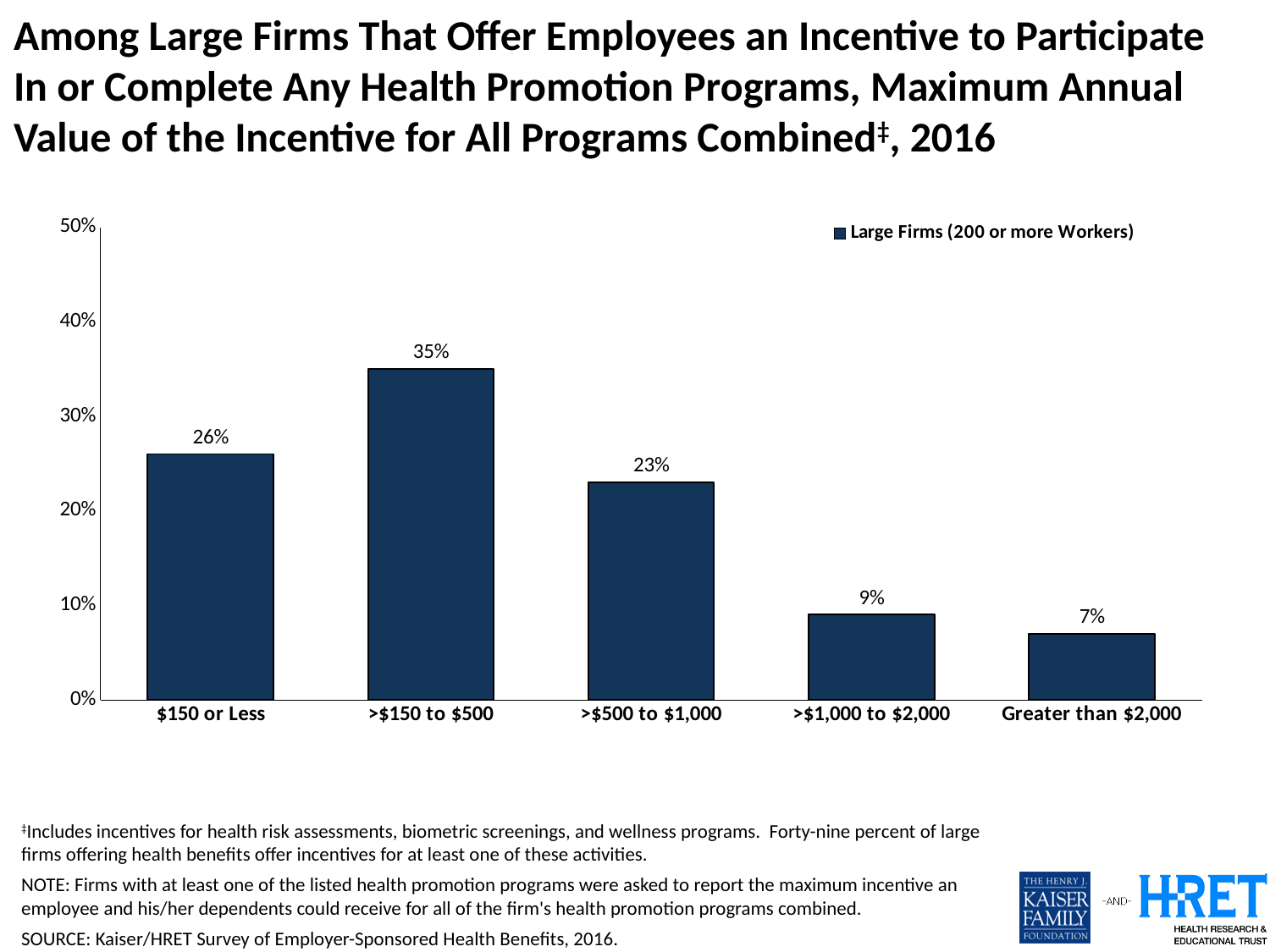
What kind of chart is shown on the slide? Bar chart What percentage of large firms report a maximum annual incentive value of $150 or less? 26% Which incentive value category has the lowest percentage? Greater than $2,000 What is the difference between the ">$150 to $500" value and the "$150 or Less" value? 9% What percentage is shown for the ">$500 to $1,000" category? 23% What is the value shown for the ">$150 to $500" category? 35% How many series does the legend list? 1 How many incentive value categories are shown on the x axis? 5 Which incentive value category has the highest percentage? >$150 to $500 What is the value for the "Greater than $2,000" category? 7% Which is larger, the value for ">$1,000 to $2,000" or the value for "Greater than $2,000"? >$1,000 to $2,000 What is the legend entry for the series shown in the chart? Large Firms (200 or more Workers)